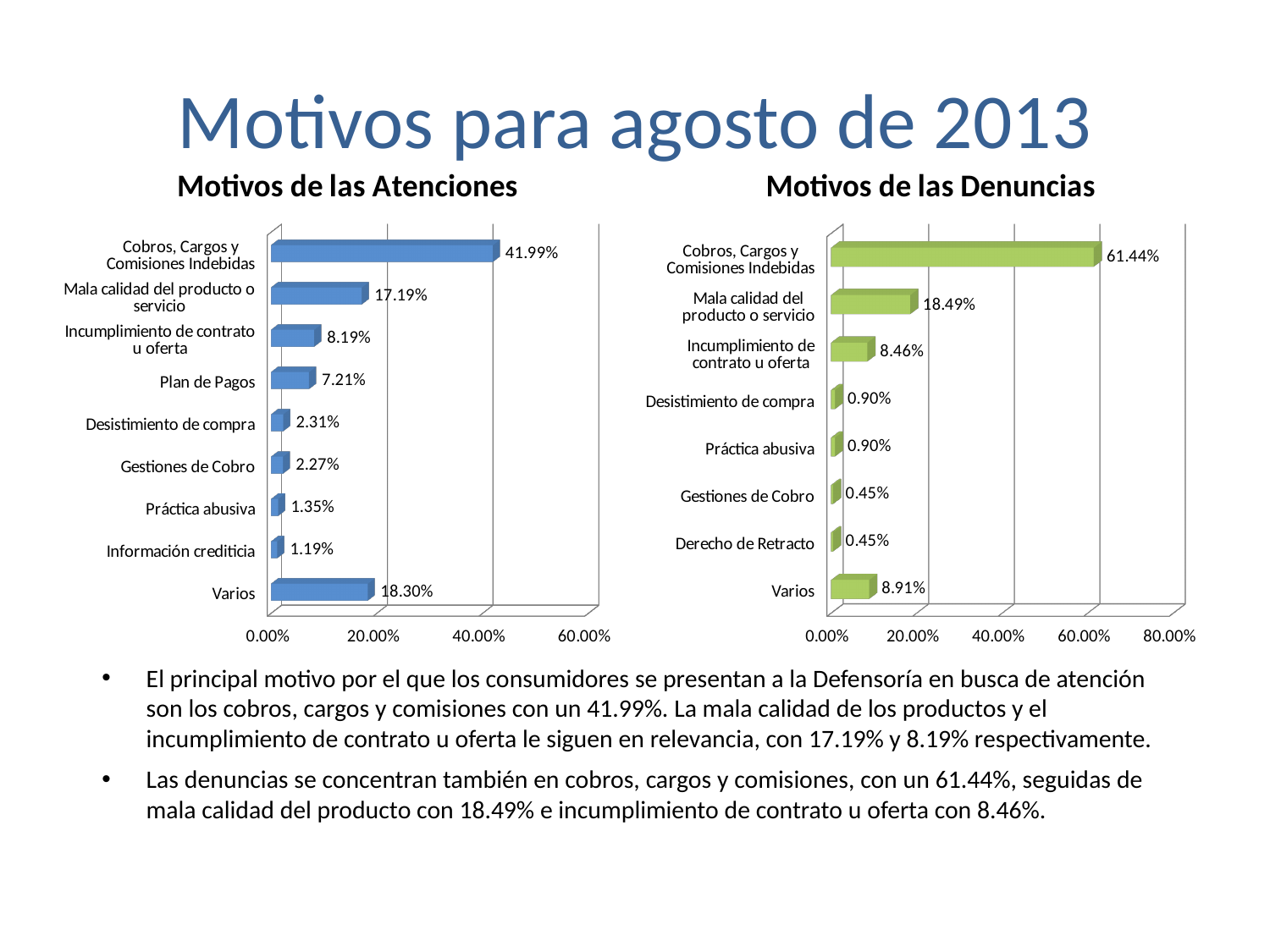
In the 'Motivos de las Denuncias' chart, what is the value for 'Varios'? 8.91% In the 'Motivos de las Denuncias' chart, is the value for 'Cobros, Cargos y Comisiones Indebidas' greater or less than 60.00%? greater In the 'Motivos de las Atenciones' chart, what is the difference between 'Cobros, Cargos y Comisiones Indebidas' and 'Mala calidad del producto o servicio'? 24.80% In the 'Motivos de las Atenciones' chart, which is larger: 'Varios' or 'Mala calidad del producto o servicio'? Varios What kind of chart is the 'Motivos de las Denuncias' chart? Bar chart How many categories are shown in the 'Motivos de las Atenciones' chart? 9 In the 'Motivos de las Atenciones' chart, what is the value for 'Cobros, Cargos y Comisiones Indebidas'? 41.99% In the 'Motivos de las Denuncias' chart, which category has the highest value? Cobros, Cargos y Comisiones Indebidas In the 'Motivos de las Atenciones' chart, which category has the lowest value? Información crediticia What colour are the bars in the 'Motivos de las Atenciones' chart? Blue In the 'Motivos de las Denuncias' chart, what is the difference between 'Cobros, Cargos y Comisiones Indebidas' and 'Mala calidad del producto o servicio'? 42.95% How many categories are shown in the 'Motivos de las Denuncias' chart? 8